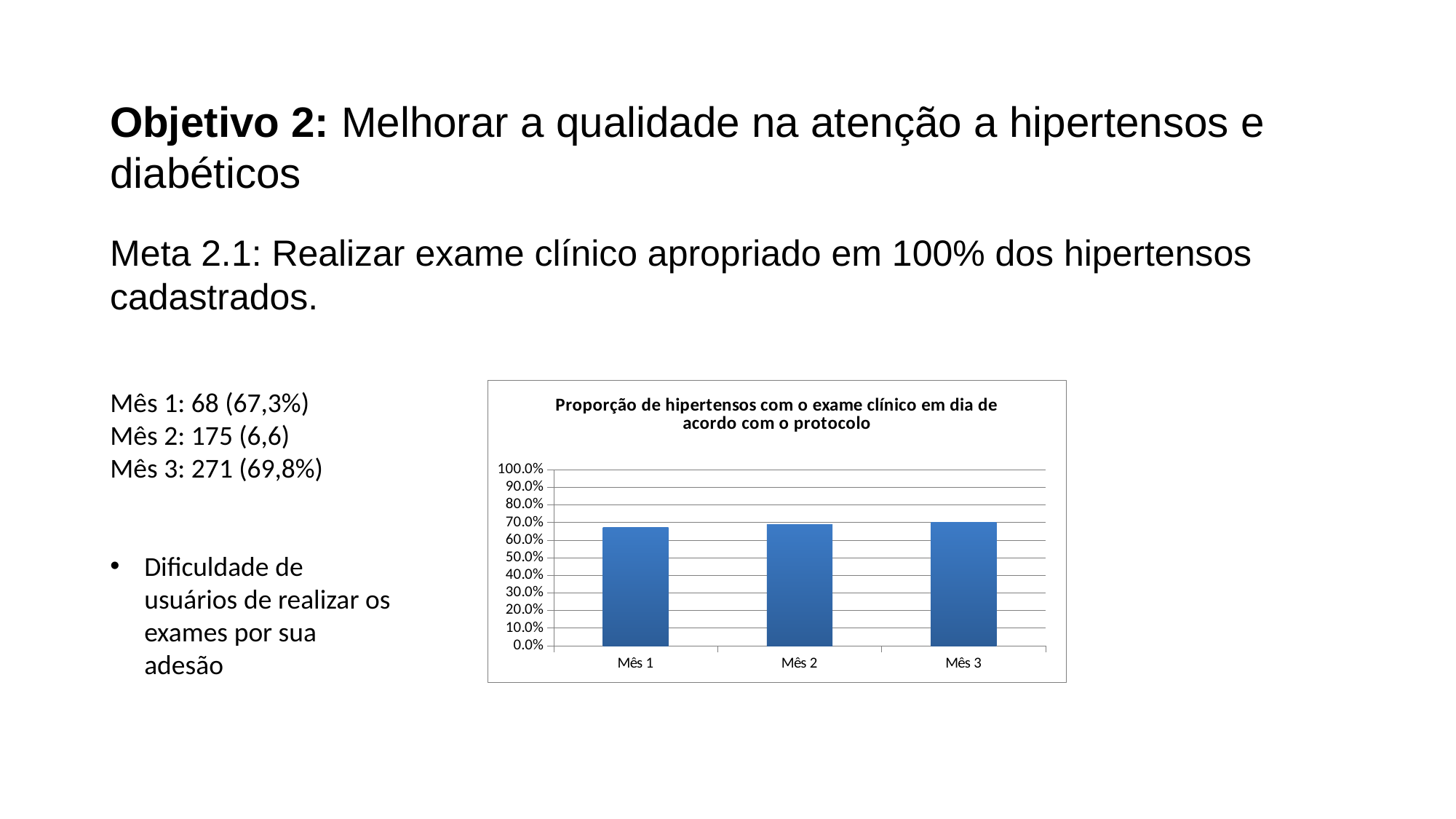
Is the value for Mês 3 greater or less than 80.0%? less What is the title of the chart? Proporção de hipertensos com o exame clínico em dia de acordo com o protocolo What kind of chart is shown on the slide? bar chart Is the value for Mês 1 greater or less than 70.0%? less Is the value for Mês 1 greater or less than 60.0%? greater Which month has the lowest value in the chart? Mês 1 According to the slide text, what proportion is reported for Mês 1? 67,3% Do the values rise or fall from Mês 1 to Mês 3? rise How many categories (months) are plotted in the chart? 3 What is the maximum value shown on the vertical axis of the chart? 100.0%